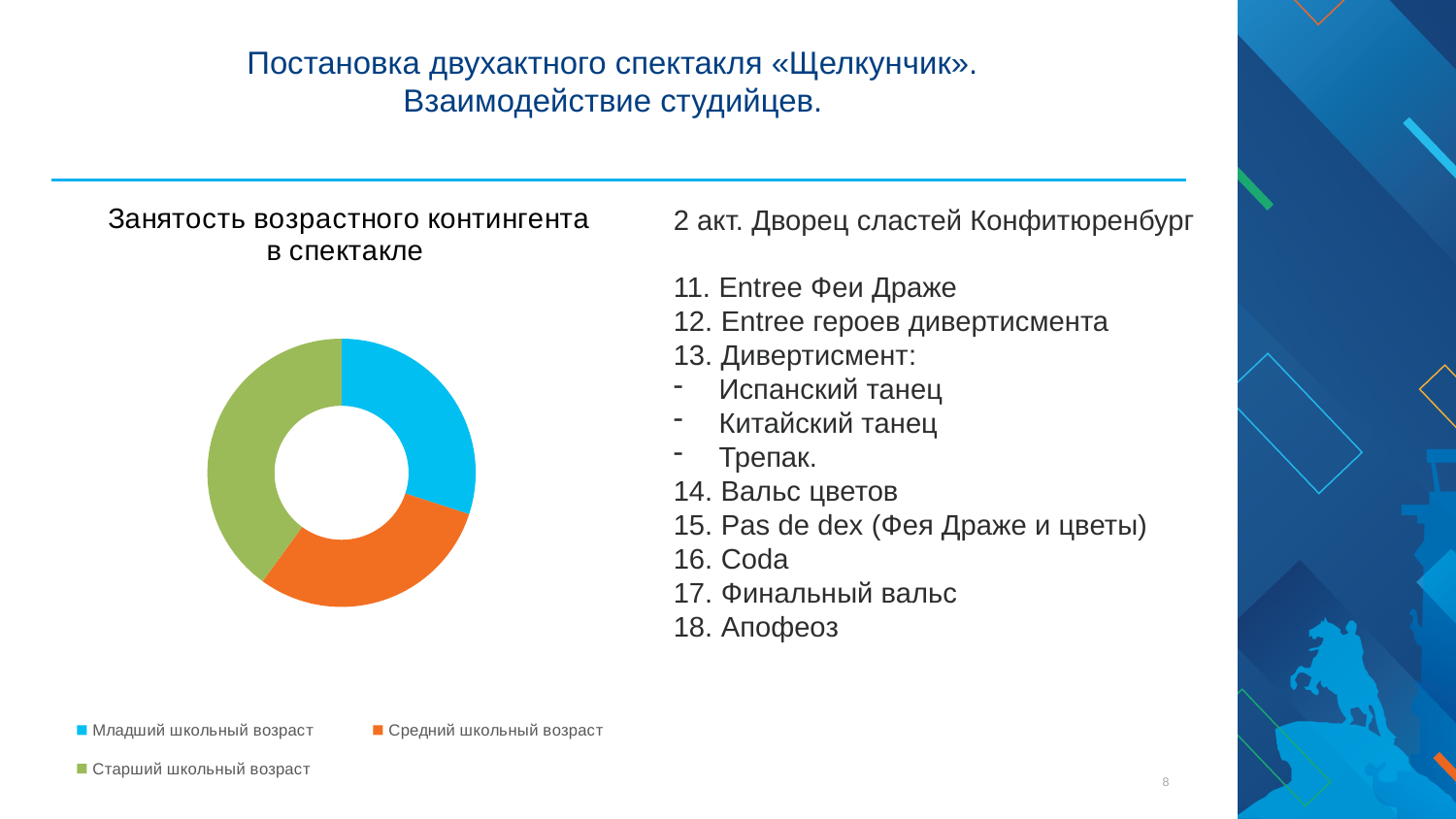
Which category has the largest share in the doughnut chart? Старший школьный возраст What is the title of the doughnut chart? Занятость возрастного контингента в спектакле How many entries does the legend of the doughnut chart list? 3 What colour represents Средний школьный возраст in the doughnut chart? Orange Which is larger in the doughnut chart: Старший школьный возраст or Средний школьный возраст? Старший школьный возраст Which is larger in the doughnut chart: Старший школьный возраст or Младший школьный возраст? Старший школьный возраст How many categories does the doughnut chart show? 3 What kind of chart is shown under the title "Занятость возрастного контингента в спектакле"? Doughnut chart